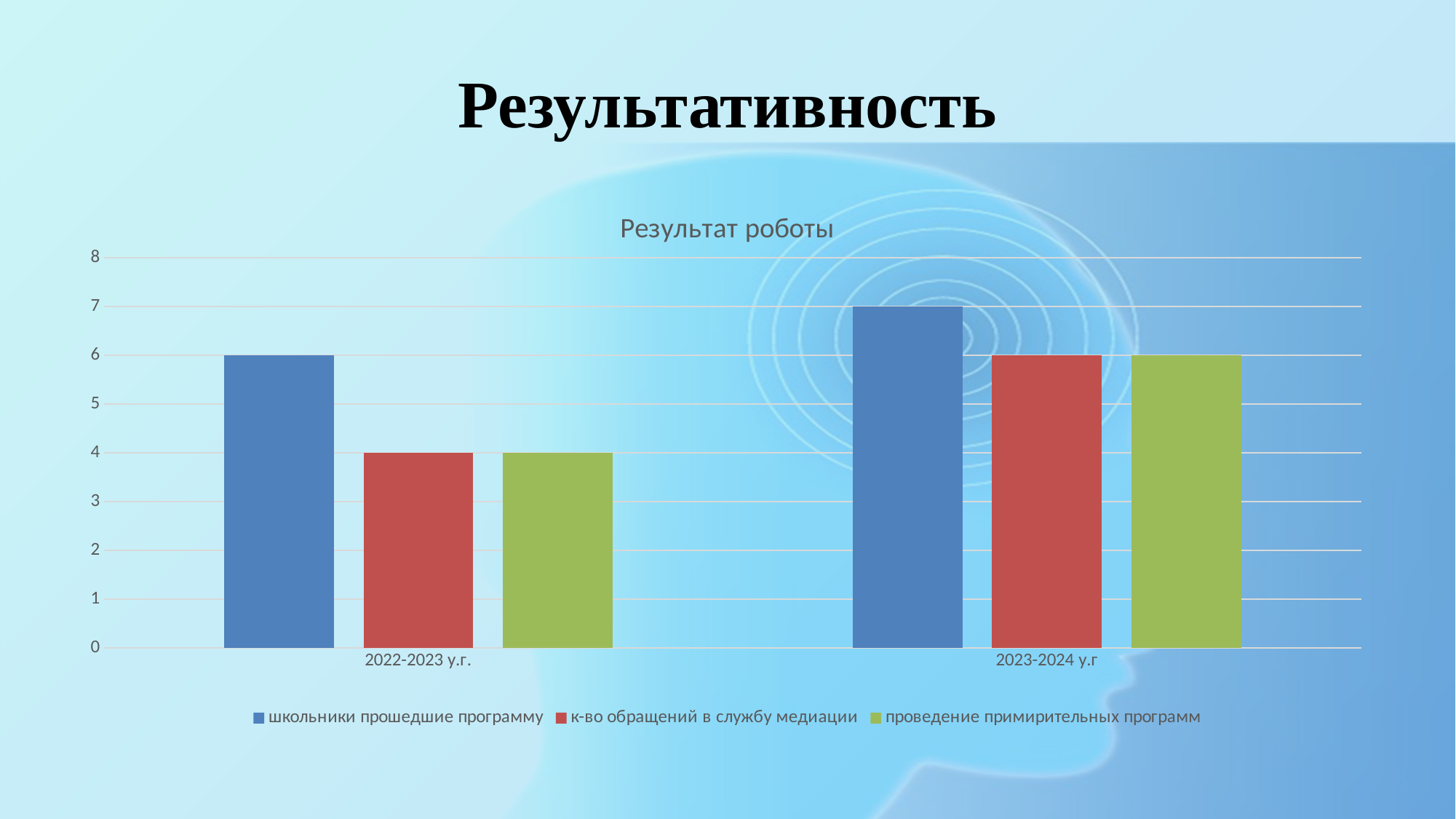
What kind of chart is shown under the title "Результат роботы"? bar chart What is the value for "школьники прошедшие программу" in 2022-2023 у.г.? 6 How many series does the legend list? 3 What is the title of the chart? Результат роботы What is the value for "проведение примирительных программ" in 2022-2023 у.г.? 4 What is the difference between the "школьники прошедшие программу" values for 2023-2024 у.г and 2022-2023 у.г.? 1 What is the value for "к-во обращений в службу медиации" in 2023-2024 у.г? 6 Which series has the highest value in 2023-2024 у.г? школьники прошедшие программу Which is larger: "к-во обращений в службу медиации" in 2022-2023 у.г. or in 2023-2024 у.г? 2023-2024 у.г How many categories are shown on the x axis? 2 What is the value for "школьники прошедшие программу" in 2023-2024 у.г? 7 Does the value for "школьники прошедшие программу" rise or fall from 2022-2023 у.г. to 2023-2024 у.г? rise